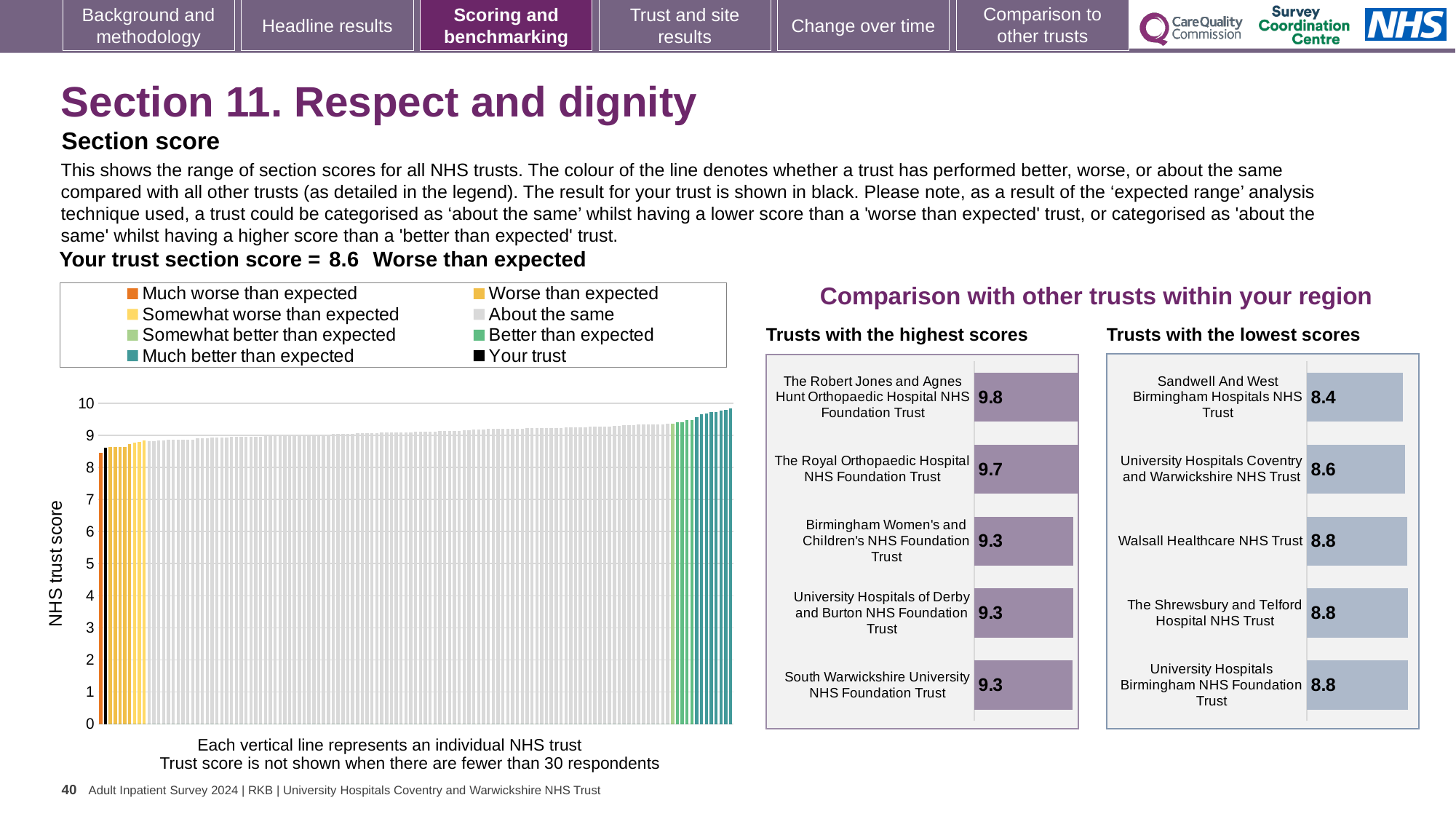
How many trusts are shown in the 'Trusts with the highest scores' chart? 5 In the 'Trusts with the lowest scores' chart, which trust has the lowest score? Sandwell And West Birmingham Hospitals NHS Trust In the 'Trusts with the highest scores' chart, what is the difference between the scores of The Robert Jones and Agnes Hunt Orthopaedic Hospital NHS Foundation Trust and South Warwickshire University NHS Foundation Trust? 0.5 In the large chart on the left, do the trust scores rise or fall from left to right along the x axis? Rise In the 'Trusts with the lowest scores' chart, what is the difference between the scores of University Hospitals Birmingham NHS Foundation Trust and Sandwell And West Birmingham Hospitals NHS Trust? 0.4 In the 'Trusts with the highest scores' chart, what is the score for The Robert Jones and Agnes Hunt Orthopaedic Hospital NHS Foundation Trust? 9.8 In the 'Trusts with the lowest scores' chart, which has the larger score: Sandwell And West Birmingham Hospitals NHS Trust or University Hospitals Coventry and Warwickshire NHS Trust? University Hospitals Coventry and Warwickshire NHS Trust In the 'Trusts with the lowest scores' chart, what is the score for Walsall Healthcare NHS Trust? 8.8 In the 'Trusts with the highest scores' chart, which trust has the highest score? The Robert Jones and Agnes Hunt Orthopaedic Hospital NHS Foundation Trust What kind of chart is the large chart on the left showing NHS trust scores? Bar chart In the 'Trusts with the lowest scores' chart, what is the score for Sandwell And West Birmingham Hospitals NHS Trust? 8.4 In the 'Trusts with the highest scores' chart, what is the score for The Royal Orthopaedic Hospital NHS Foundation Trust? 9.7